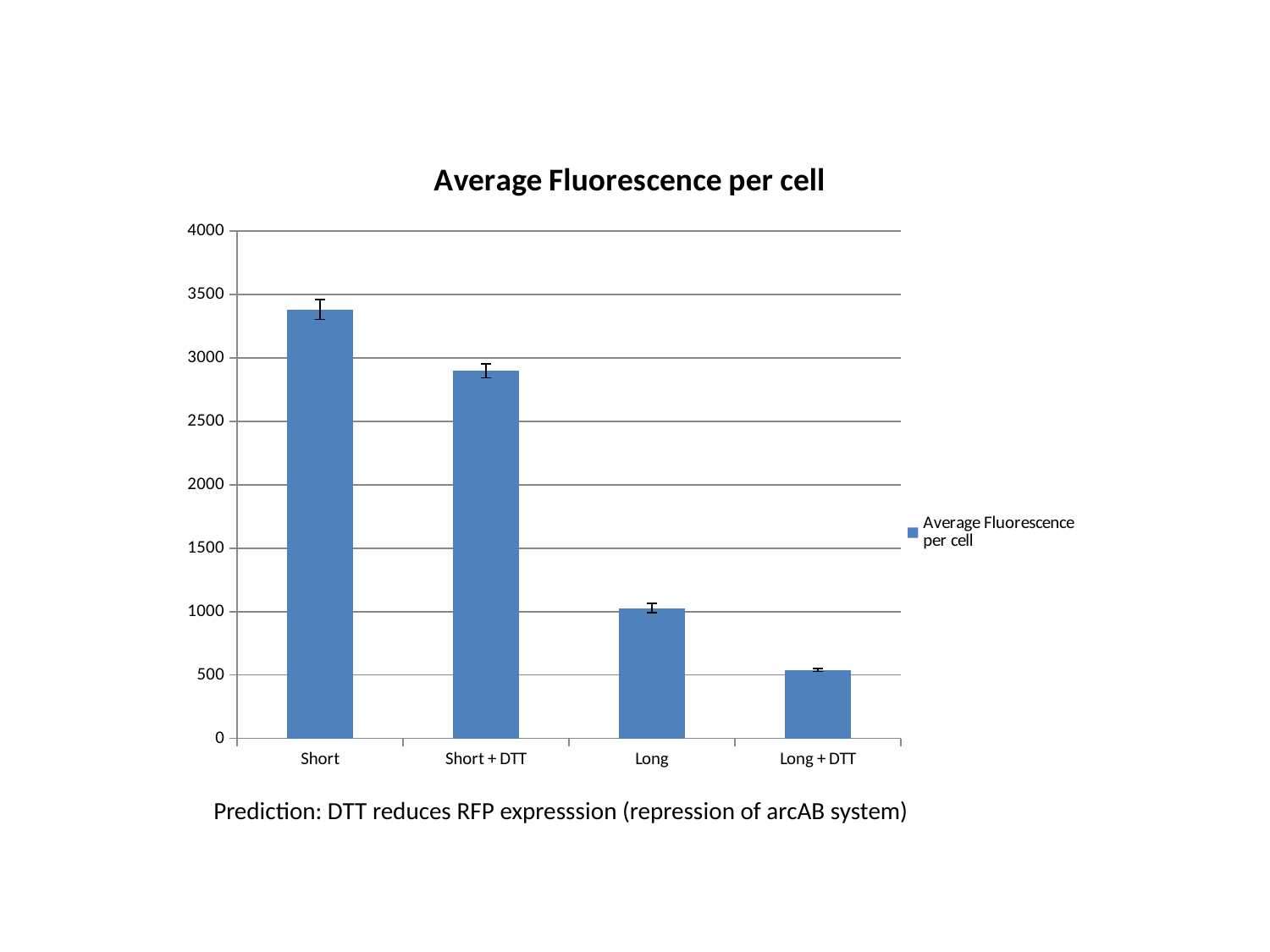
What type of chart is shown on the slide? bar chart Do the values rise or fall from left to right along the x axis? fall Is the value for Short greater or less than 3000? greater Is the value for Long + DTT greater or less than 1000? less How many categories are shown on the x axis? 4 Is the value for Short + DTT greater or less than 3000? less Which category has the highest average fluorescence per cell? Short How many series does the legend list? 1 What is the title of the chart? Average Fluorescence per cell Which is larger, the value for Short + DTT or the value for Long? Short + DTT Which category has the lowest average fluorescence per cell? Long + DTT